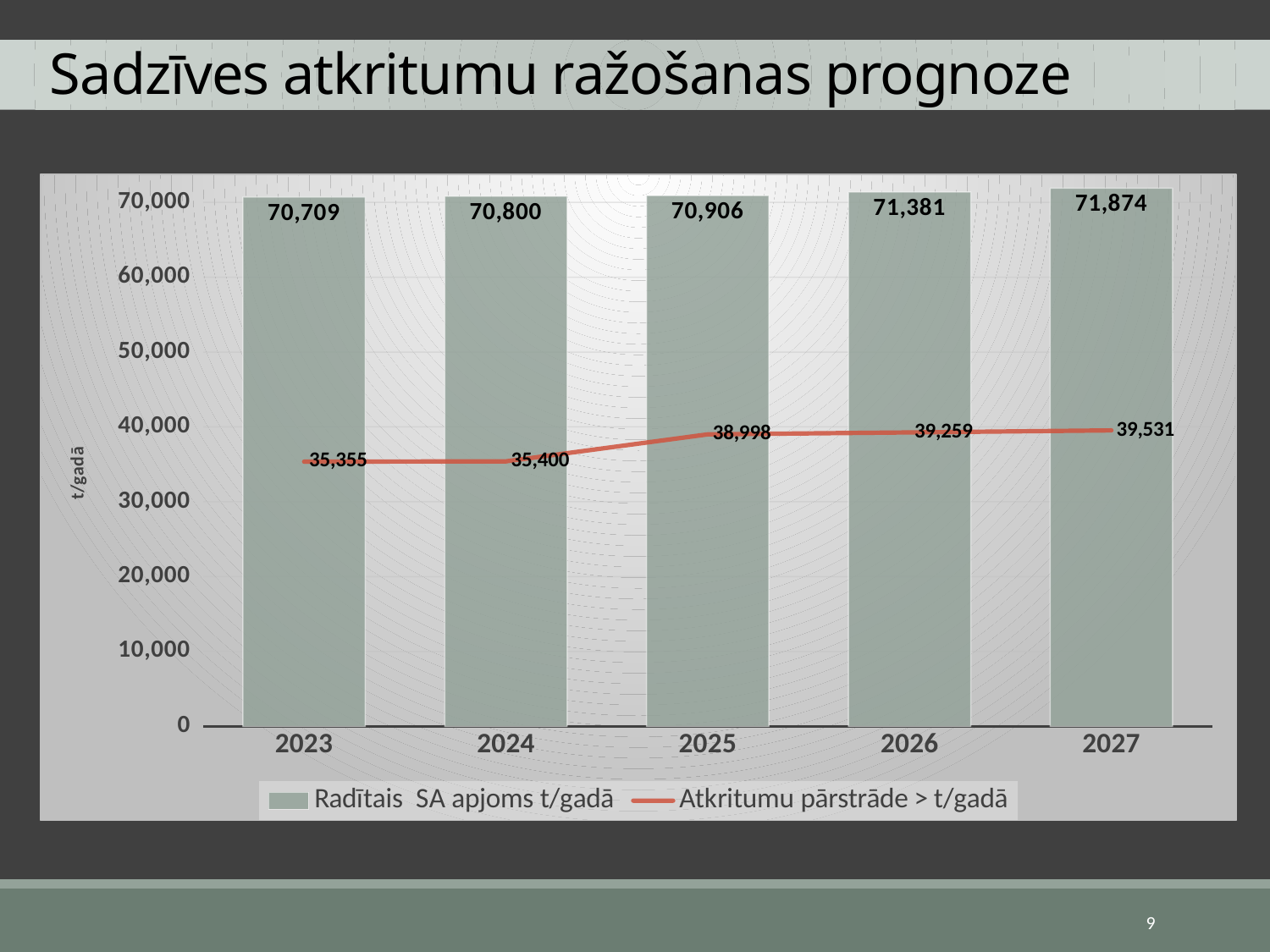
Does the 'Atkritumu pārstrāde > t/gadā' series rise or fall from 2023 to 2027? rise What is the value of 'Atkritumu pārstrāde > t/gadā' for 2027? 39,531 How many series does the legend list? 2 What is the difference between the 'Radītais SA apjoms t/gadā' values for 2027 and 2023? 1,165 What is the difference between the 'Atkritumu pārstrāde > t/gadā' values for 2025 and 2024? 3,598 What is the value of 'Atkritumu pārstrāde > t/gadā' for 2023? 35,355 Which year has the lowest value for 'Atkritumu pārstrāde > t/gadā'? 2023 Which year has the highest value for 'Radītais SA apjoms t/gadā'? 2027 Is the 'Atkritumu pārstrāde > t/gadā' value for 2026 greater or less than 'Radītais SA apjoms t/gadā' for 2026? less What is the title of the slide? Sadzīves atkritumu ražošanas prognoze How many years are shown on the x axis? 5 What is the value of 'Radītais SA apjoms t/gadā' for 2025? 70,906